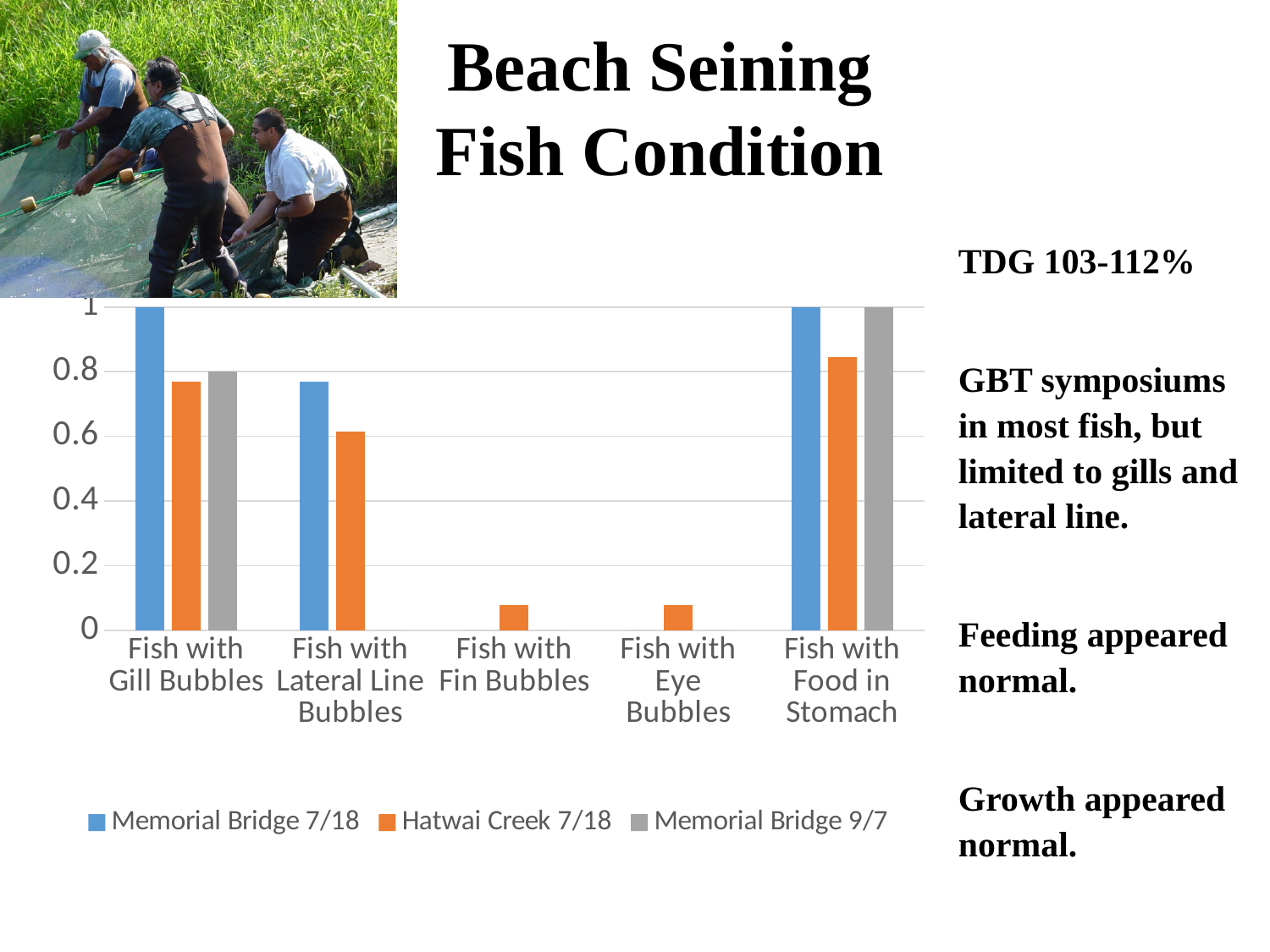
How many series does the chart's legend list? 3 Is the value for Fish with Fin Bubbles in the Hatwai Creek 7/18 series greater or less than 0.2? less What is the difference between the Memorial Bridge 7/18 and Memorial Bridge 9/7 values for Fish with Gill Bubbles? 0.2 What kind of chart is shown on the slide? bar chart For Fish with Lateral Line Bubbles, which series has the larger value: Memorial Bridge 7/18 or Hatwai Creek 7/18? Memorial Bridge 7/18 How many categories are shown along the x axis of the chart? 5 What colour represents the Hatwai Creek 7/18 series in the chart? orange Which category has the highest value in the Hatwai Creek 7/18 series? Fish with Food in Stomach What is the value for Fish with Gill Bubbles in the Memorial Bridge 9/7 series? 0.8 What is the value for Fish with Food in Stomach in the Memorial Bridge 7/18 series? 1 Is the value for Fish with Lateral Line Bubbles in the Hatwai Creek 7/18 series greater or less than 0.8? less For Fish with Gill Bubbles, which series has the larger value: Memorial Bridge 7/18 or Hatwai Creek 7/18? Memorial Bridge 7/18